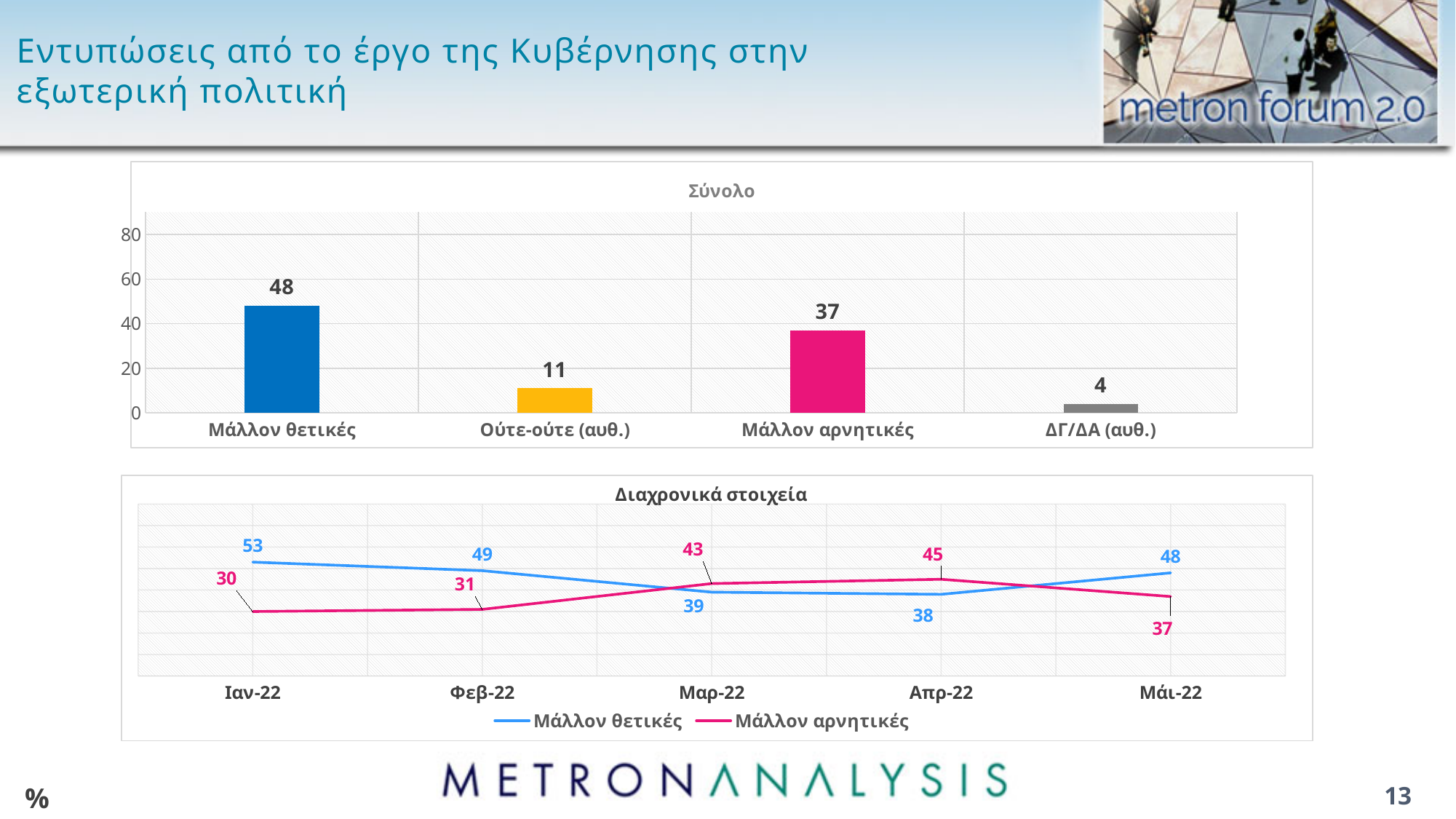
In the 'Διαχρονικά στοιχεία' chart, what is the difference between 'Μάλλον θετικές' and 'Μάλλον αρνητικές' in Ιαν-22? 23 In the 'Σύνολο' chart, how many categories are shown? 4 In the 'Διαχρονικά στοιχεία' chart, in which month is 'Μάλλον θετικές' highest? Ιαν-22 What kind of chart is the 'Σύνολο' chart? bar chart In the 'Διαχρονικά στοιχεία' chart, how many series does the legend list? 2 In the 'Διαχρονικά στοιχεία' chart, what is the value for 'Μάλλον αρνητικές' in Μαρ-22? 43 What kind of chart is the 'Διαχρονικά στοιχεία' chart? line chart In the 'Διαχρονικά στοιχεία' chart, which is larger in Απρ-22: 'Μάλλον θετικές' or 'Μάλλον αρνητικές'? Μάλλον αρνητικές In the 'Διαχρονικά στοιχεία' chart, does 'Μάλλον θετικές' rise or fall from Ιαν-22 to Απρ-22? fall In the 'Σύνολο' chart, which category has the lowest value? ΔΓ/ΔΑ (αυθ.) In the 'Σύνολο' chart, what is the value for 'Μάλλον θετικές'? 48 In the 'Σύνολο' chart, what is the difference between 'Μάλλον θετικές' and 'Μάλλον αρνητικές'? 11